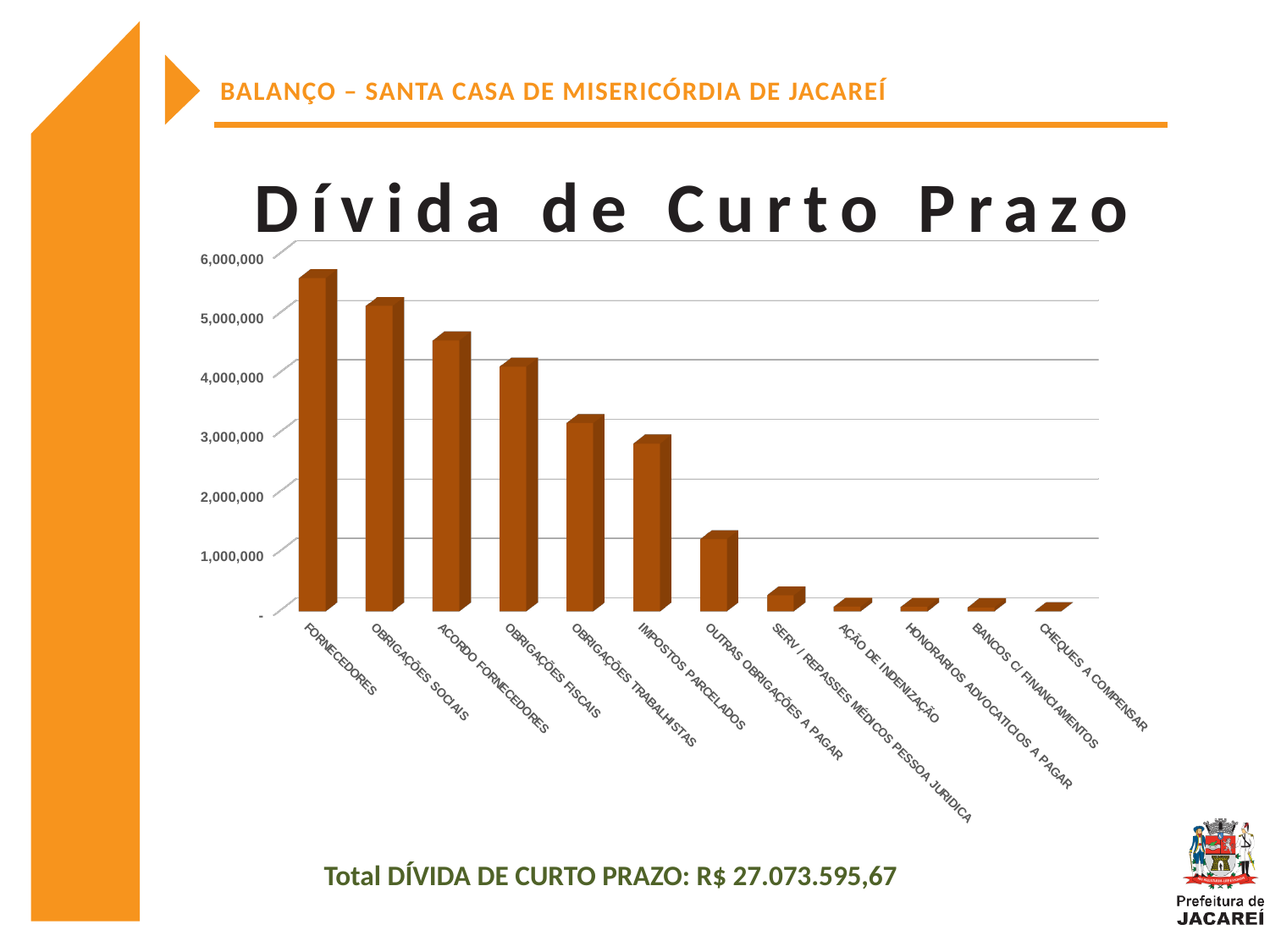
Is the value for IMPOSTOS PARCELADOS greater or less than 2,000,000? greater Is the value for OUTRAS OBRIGAÇÕES A PAGAR greater or less than 2,000,000? less Which category has the highest value? FORNECEDORES What kind of chart is shown on the slide? bar chart How many categories are plotted in the chart? 12 Is the value for OBRIGAÇÕES FISCAIS greater or less than 5,000,000? less What is the title of the chart? Dívida de Curto Prazo Which is larger, the value for OBRIGAÇÕES TRABALHISTAS or the value for OUTRAS OBRIGAÇÕES A PAGAR? OBRIGAÇÕES TRABALHISTAS Which is larger, the value for OBRIGAÇÕES SOCIAIS or the value for ACORDO FORNECEDORES? OBRIGAÇÕES SOCIAIS What is the highest value shown on the vertical axis of the chart? 6,000,000 Do the values rise or fall moving from left to right along the x axis? fall